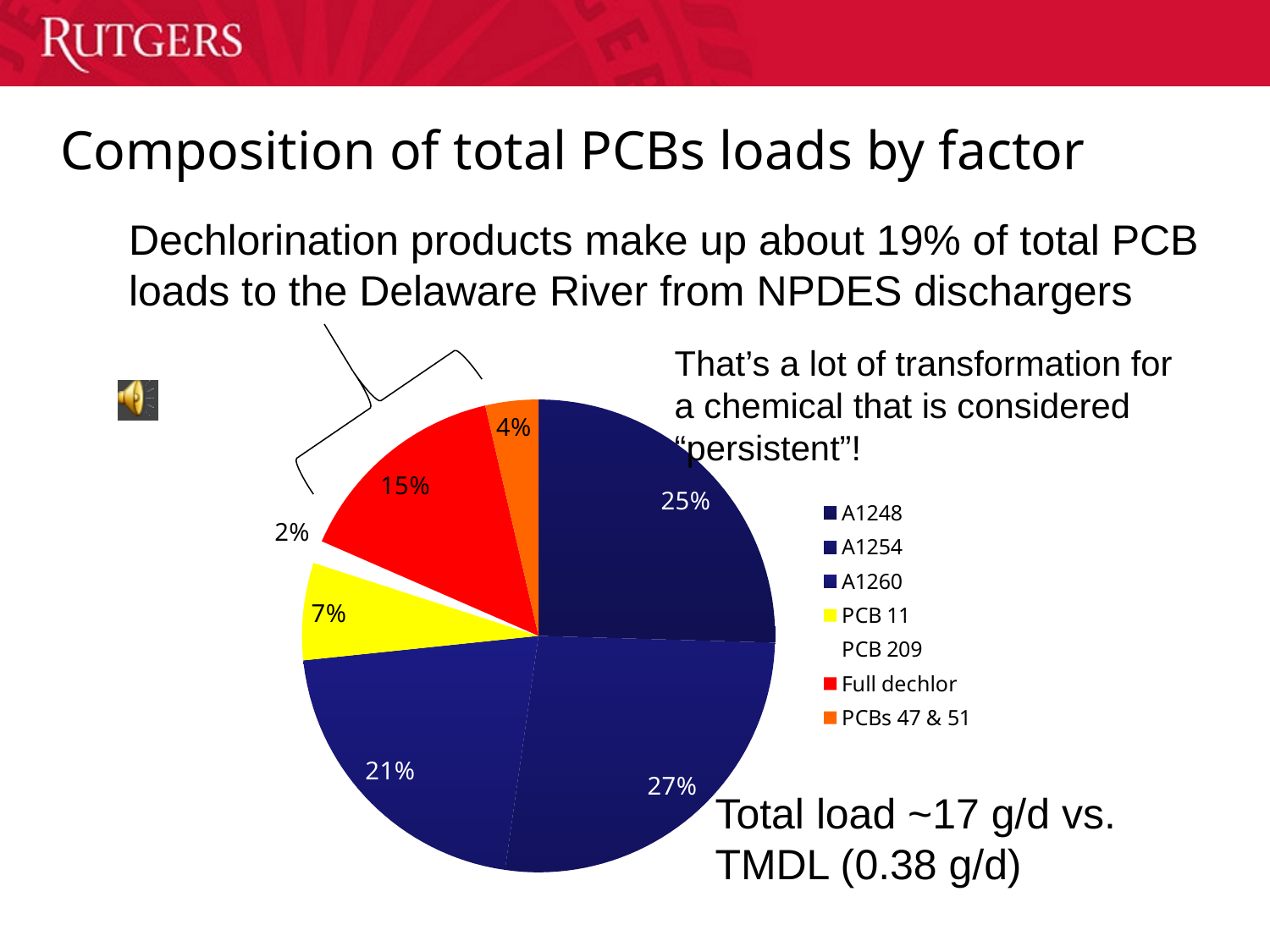
How many entries does the legend of the pie chart list? 7 Which slice of the pie chart is the smallest? PCB 209 How many slices does the pie chart have? 7 What kind of chart is shown on the slide? pie chart What share of the pie does PCB 209 (the white slice) represent? 2% What share of the pie does PCB 11 (the yellow slice) represent? 7% Which is larger, the Full dechlor slice or the PCB 11 slice? Full dechlor What share of the pie does PCBs 47 & 51 (the orange slice) represent? 4% What is the largest percentage labelled on the pie chart? 27% What is the difference in percentage points between the Full dechlor slice (15%) and the PCBs 47 & 51 slice (4%)? 11 What colour is the Full dechlor slice in the pie chart? red